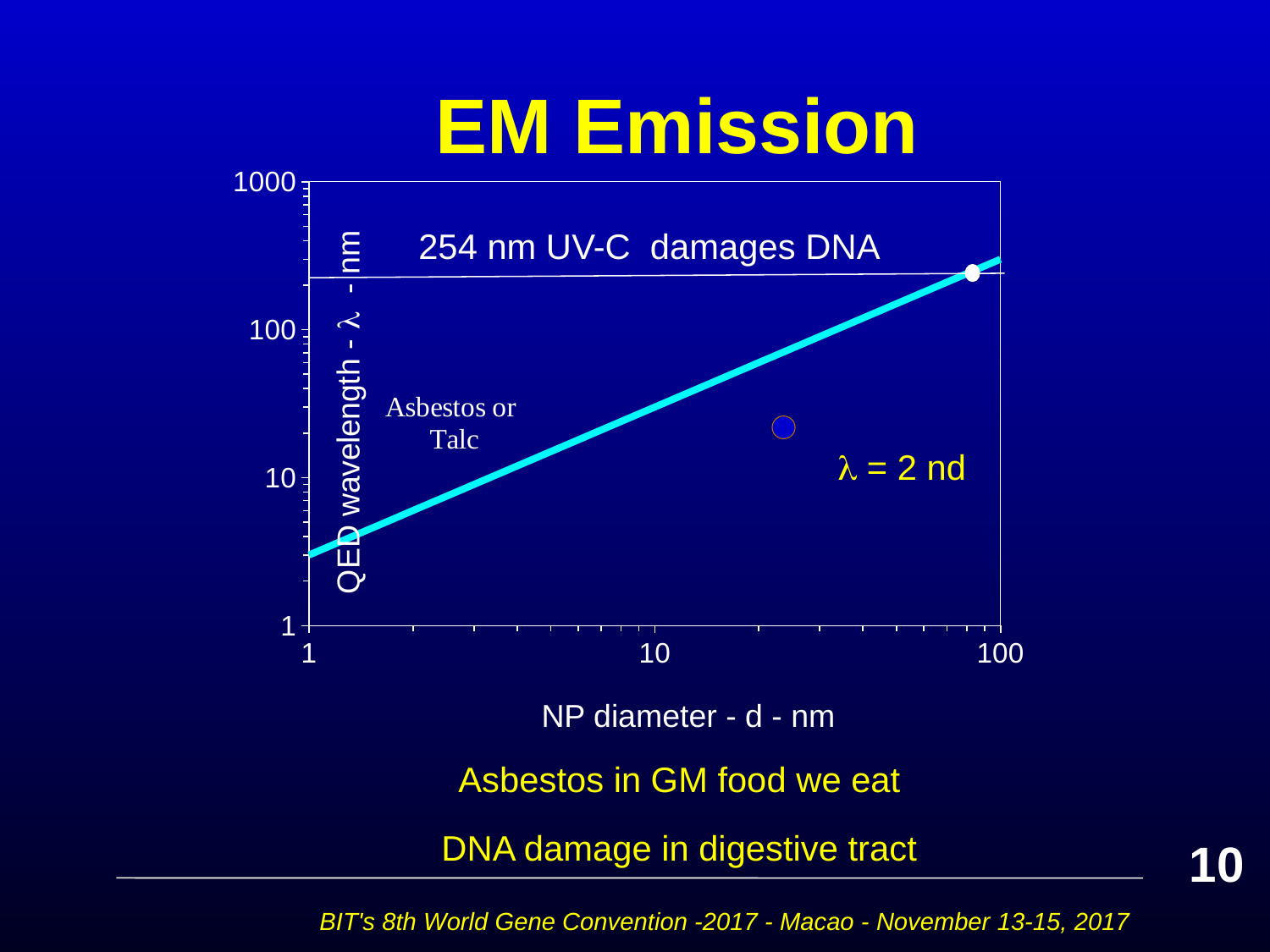
How many labeled tick values are there on the x axis? 3 Is the QED wavelength for the Asbestos or Talc point greater or less than 10? greater At what wavelength is the horizontal line marked as UV-C that damages DNA? 254 nm Does the QED wavelength rise or fall as NP diameter increases along the x axis? rise Is the QED wavelength for the Asbestos or Talc point greater or less than 100? less What kind of chart is shown on the slide? line chart What equation is printed next to the cyan line? λ = 2 nd Is the NP diameter of the Asbestos or Talc point greater or less than 10? greater What is the highest value labeled on the y axis? 1000 What is the label of the x axis? NP diameter - d - nm What is the title of the chart? EM Emission